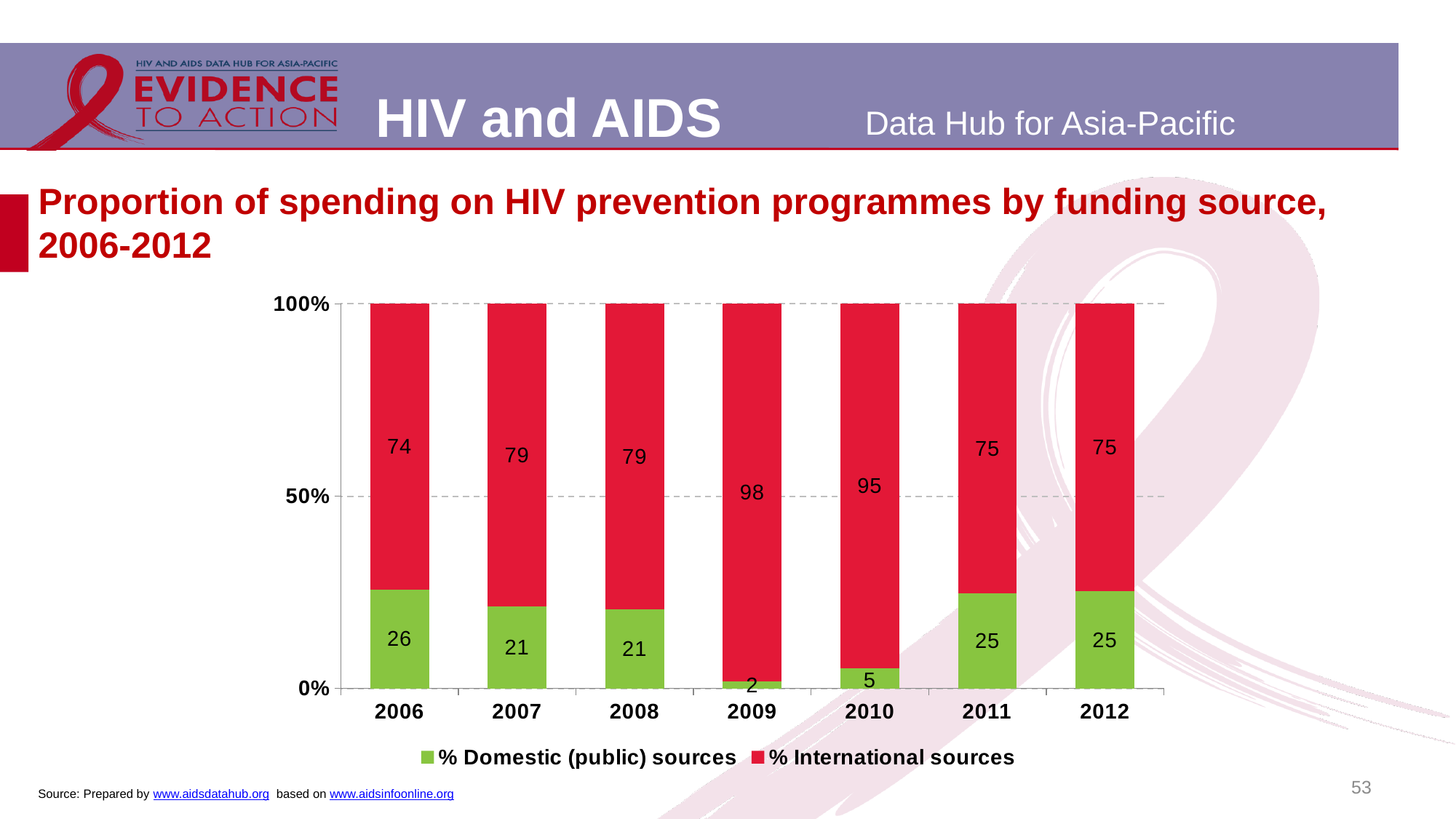
What is the value for % Domestic (public) sources in 2010? 5 What kind of chart is shown on the slide? Stacked bar chart Which is larger: % Domestic (public) sources in 2011 or in 2008? 2011 In which year is % International sources highest? 2009 In which year is % Domestic (public) sources highest? 2006 What is the value for % Domestic (public) sources in 2006? 26 Which colour represents % International sources? Red How many years are shown on the x axis? 7 How many series does the legend list? 2 What is the difference between % International sources in 2009 and in 2006? 24 What is the value for % International sources in 2009? 98 In which year is % Domestic (public) sources lowest? 2009